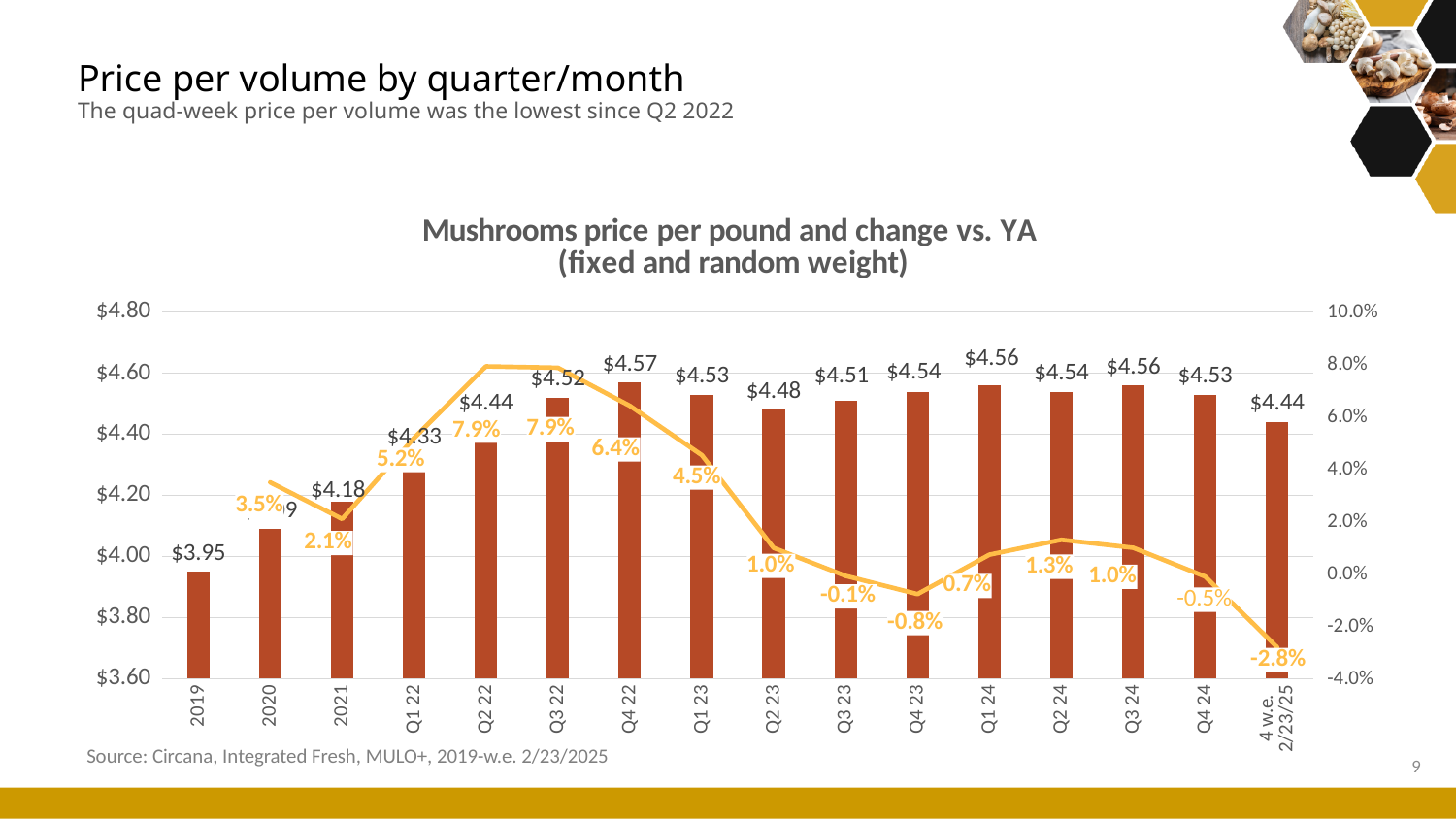
What is the change vs. YA shown for Q2 23? 1.0% What is the difference in price per pound between Q4 22 and 2019? $0.62 Which period has the lowest price per pound? 2019 What is the difference in price per pound between Q3 22 and Q2 22? $0.08 Is the price per pound for 2019 greater or less than $4.00? less What is the change vs. YA shown for Q4 23? -0.8% Which period has the lowest change vs. YA? 4 w.e. 2/23/25 What is the price per pound for the 4 w.e. 2/23/25 period? $4.44 Which period has the highest price per pound? Q4 22 How many periods are shown on the x axis? 16 What kind of chart is this? Combination bar and line chart What is the mushrooms price per pound for Q4 22? $4.57